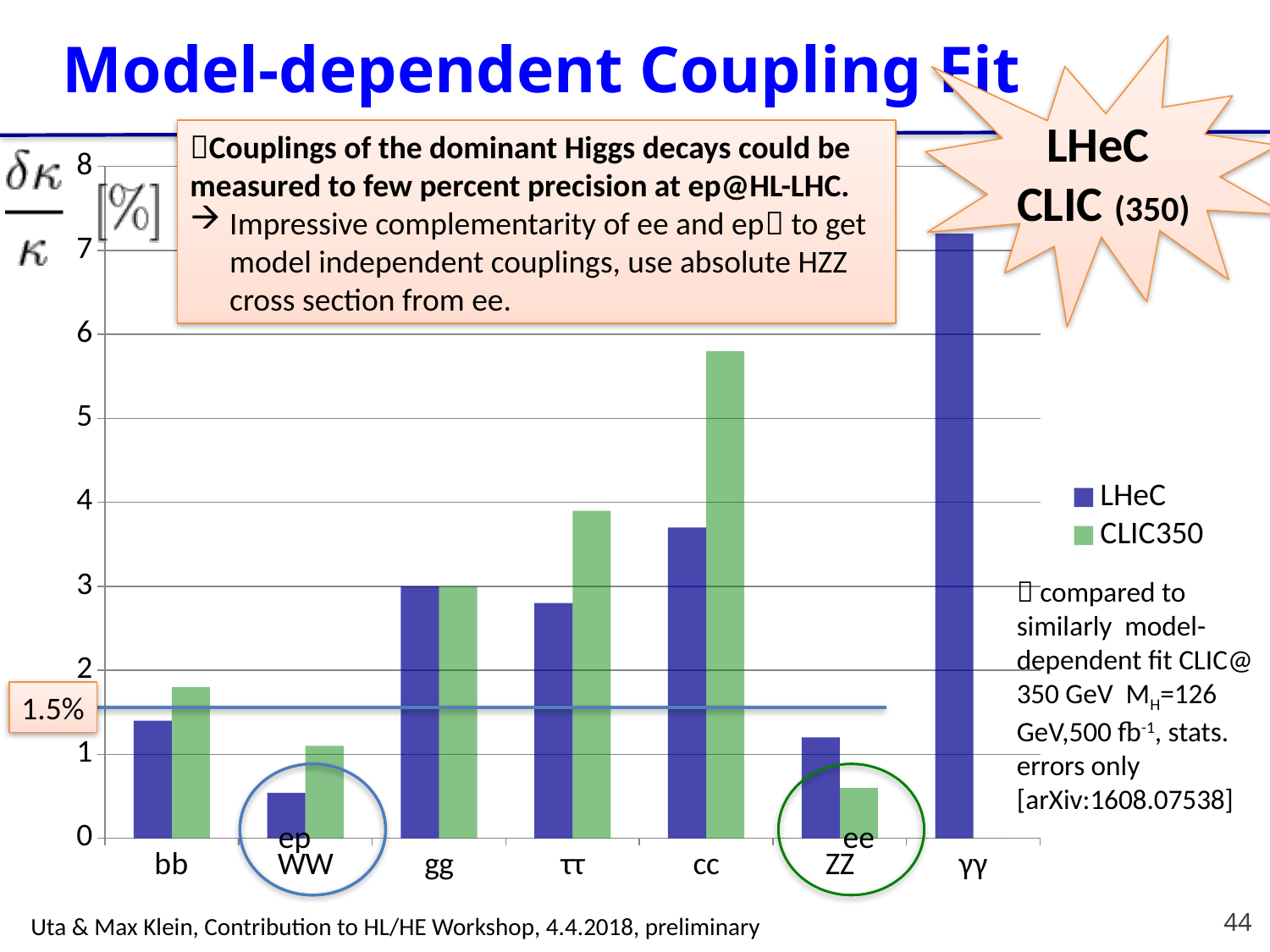
How many series does the chart legend list? 2 What kind of chart is shown on the slide? bar chart Which category has the highest CLIC350 value? cc Which category has the highest LHeC value? γγ How many categories are shown on the x axis of the chart? 7 Which category has the lowest LHeC value? WW Is the LHeC value for γγ greater or less than 7? greater Is the CLIC350 value for cc greater or less than 5? greater Which series is shown in green in the chart legend? CLIC350 For ZZ, which series has the larger value, LHeC or CLIC350? LHeC For ττ, which series has the larger value, LHeC or CLIC350? CLIC350